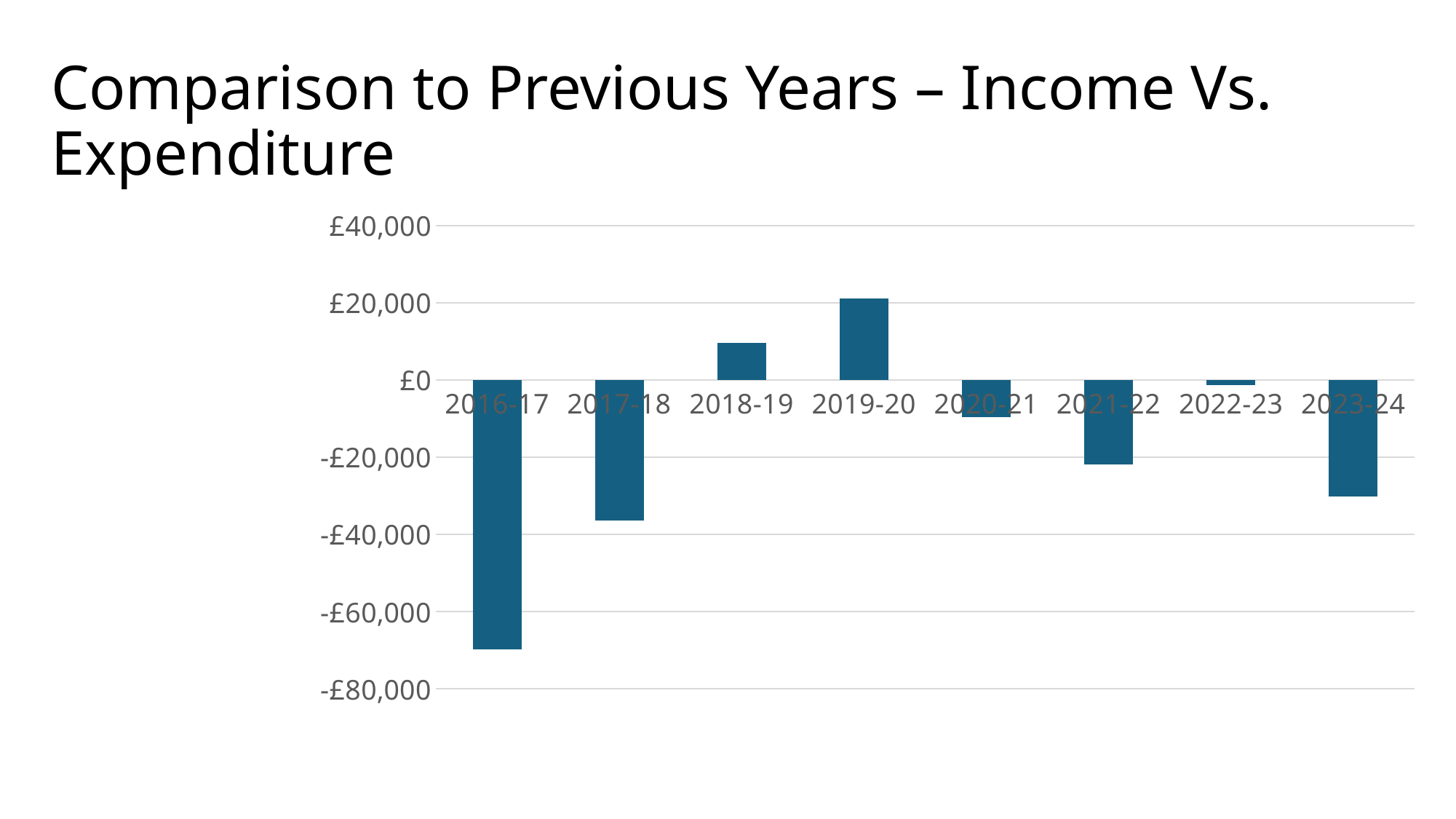
Which year has the highest value in the chart? 2019-20 Is the value for 2018-19 greater or less than £0? greater Which is larger, the value for 2018-19 or the value for 2019-20? 2019-20 Is the value for 2016-17 greater or less than -£60,000? less What is the title of the slide containing the chart? Comparison to Previous Years – Income Vs. Expenditure Which is larger, the value for 2016-17 or the value for 2017-18? 2017-18 Is the value for 2020-21 greater or less than -£20,000? greater What kind of chart is shown on the slide? bar chart Which year has the lowest value in the chart? 2016-17 How many years are shown on the x axis of the chart? 8